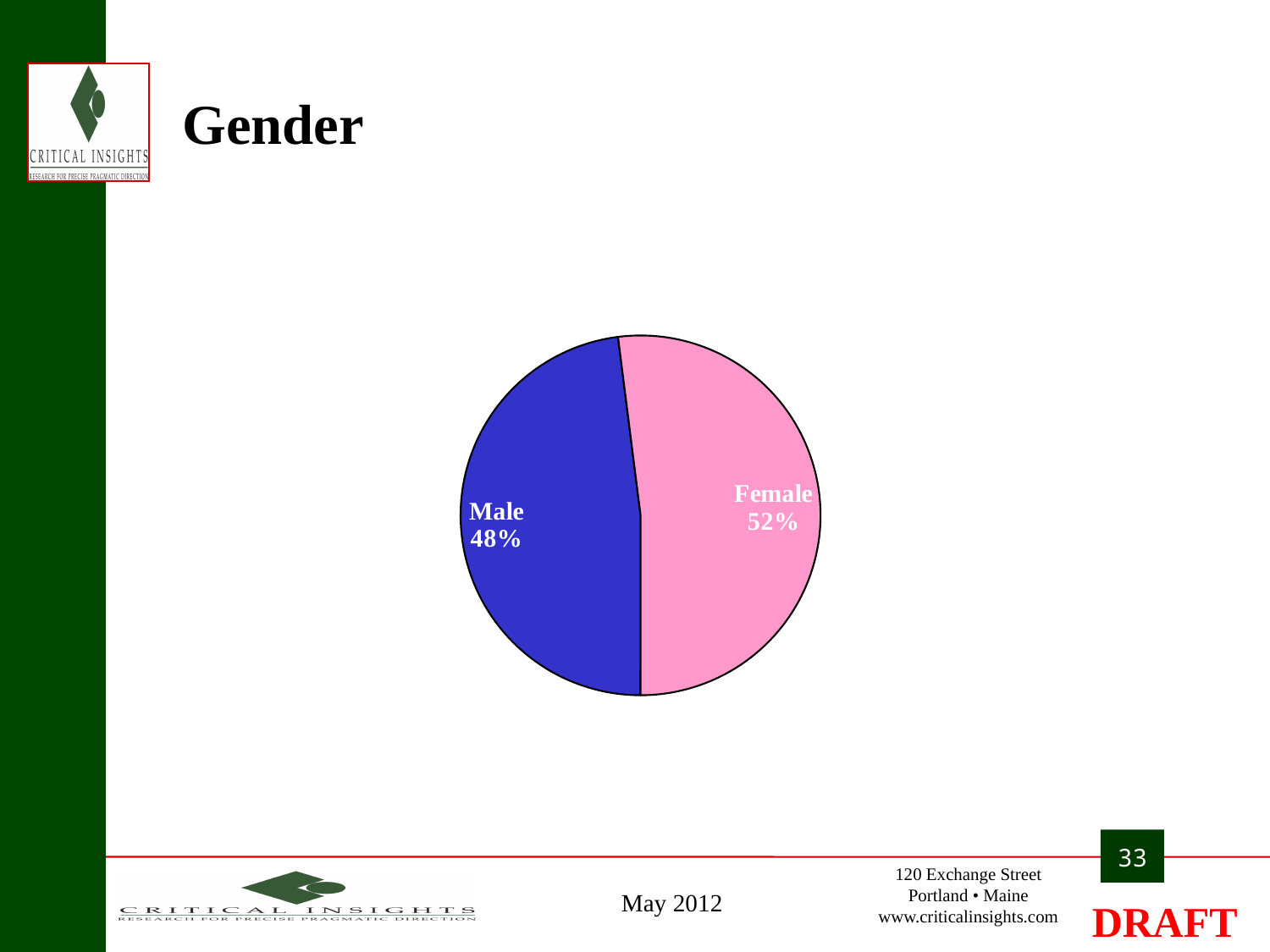
What share of the pie does the Female slice represent? 52% Which gender has the smaller share of the pie? Male Is the Female share greater or less than 50%? greater Which gender has the larger share of the pie? Female How many slices does the pie chart have? 2 What percentage of respondents are Female? 52% Is the Male share larger or smaller than the Female share? smaller What percentage of respondents are Male? 48% What is the title of the slide? Gender What colour is the Male slice of the pie? blue What kind of chart is shown on the slide? pie chart What is the difference in percentage points between the Female and Male shares? 4